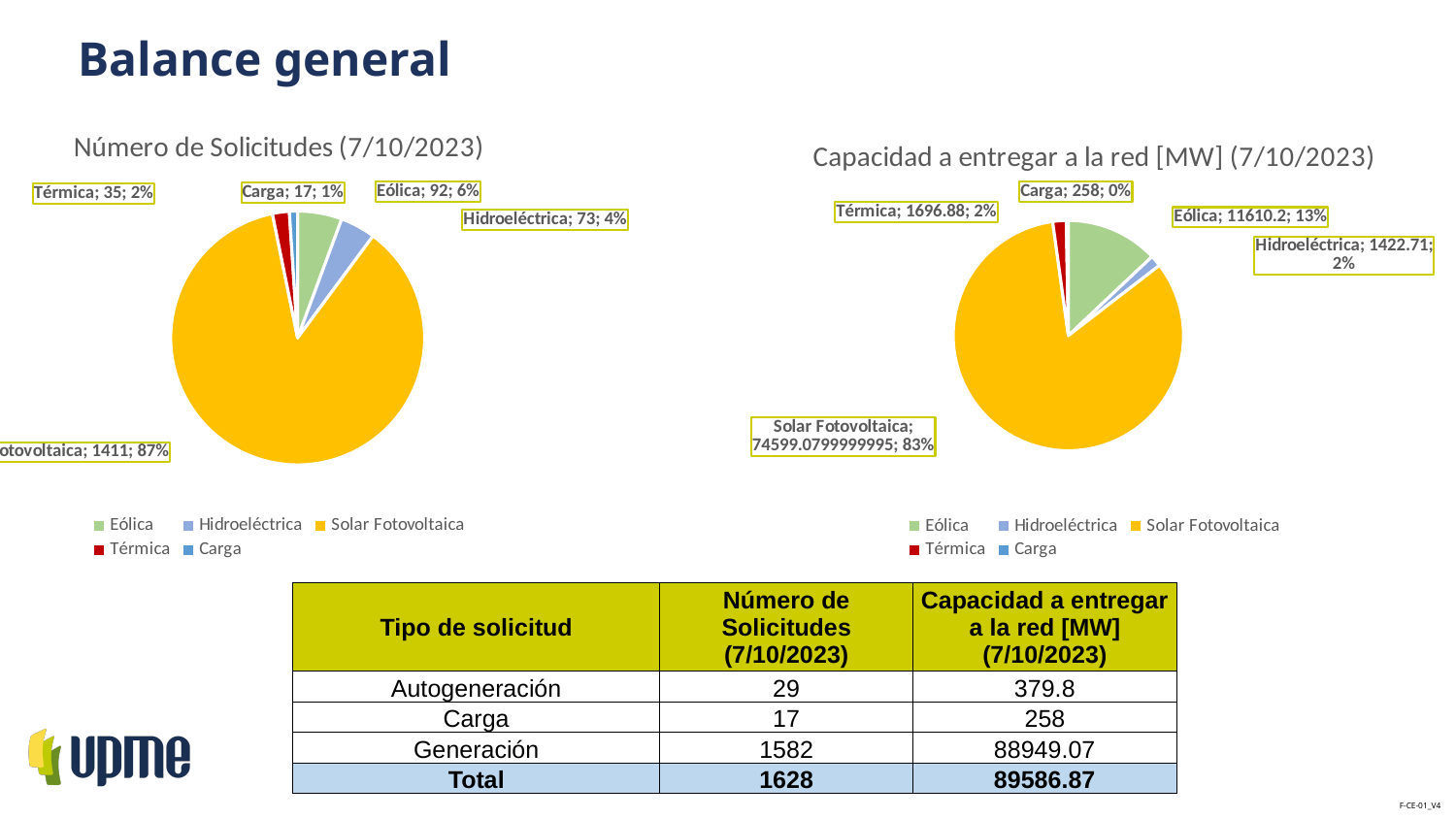
In the 'Capacidad a entregar a la red [MW] (7/10/2023)' chart, what is the value for Eólica? 11610.2 In the 'Número de Solicitudes (7/10/2023)' chart, what is the value for Eólica? 92 How many categories does the legend of the 'Número de Solicitudes (7/10/2023)' chart list? 5 In the 'Capacidad a entregar a la red [MW] (7/10/2023)' chart, which is larger, Hidroeléctrica or Carga? Hidroeléctrica In the 'Capacidad a entregar a la red [MW] (7/10/2023)' chart, which category has the largest slice? Solar Fotovoltaica What type of chart is 'Capacidad a entregar a la red [MW] (7/10/2023)'? Pie chart In the 'Capacidad a entregar a la red [MW] (7/10/2023)' chart, what is the value for Térmica? 1696.88 In the 'Capacidad a entregar a la red [MW] (7/10/2023)' chart, what share of the pie does Eólica have? 13% In the 'Número de Solicitudes (7/10/2023)' chart, what share of the pie does Solar Fotovoltaica have? 87% In the 'Número de Solicitudes (7/10/2023)' chart, what is the difference between the values for Eólica and Térmica? 57 In the 'Número de Solicitudes (7/10/2023)' chart, what is the value for Hidroeléctrica? 73 In the 'Número de Solicitudes (7/10/2023)' chart, which category has the smallest slice? Carga